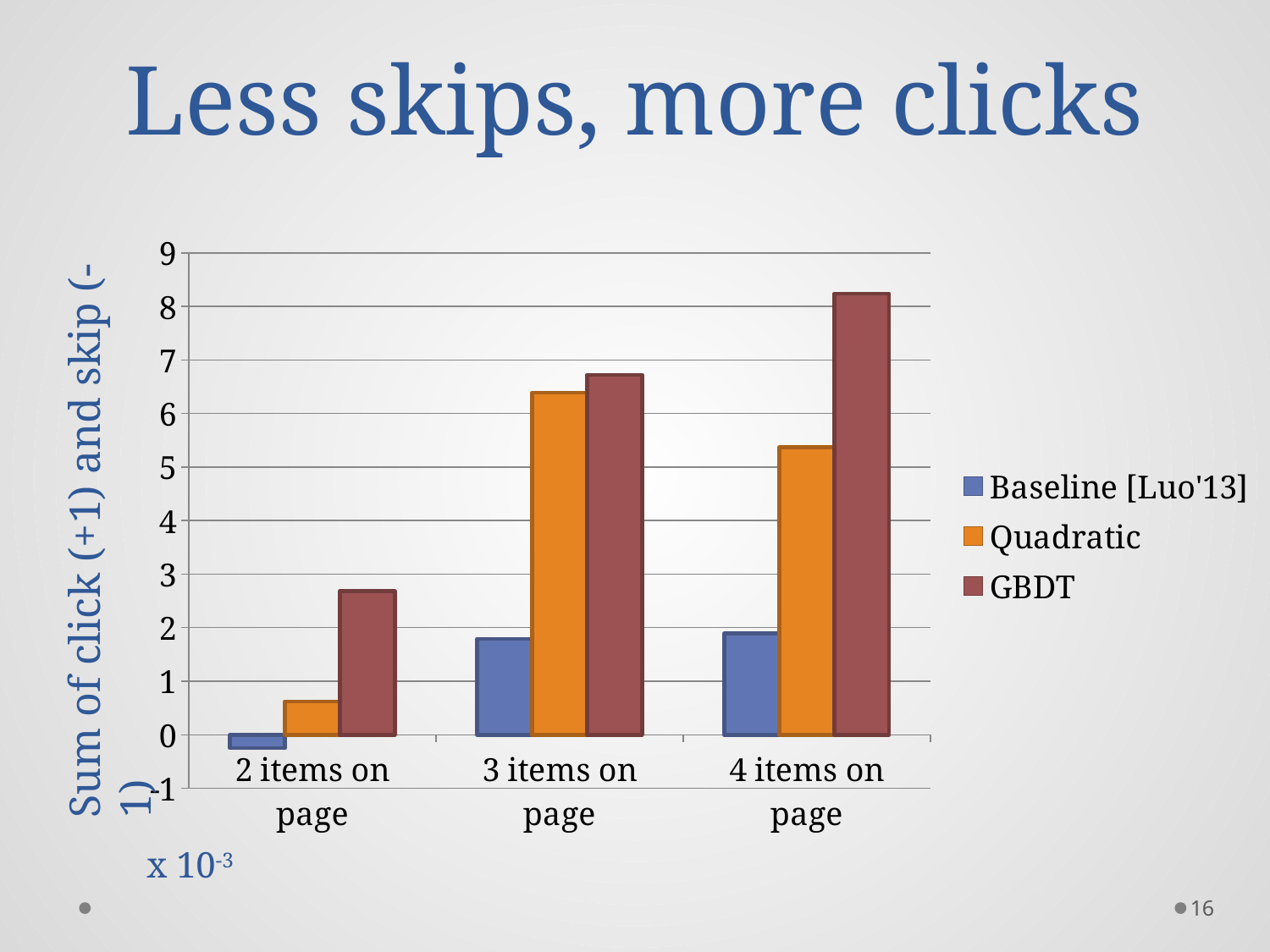
Which is larger: the GBDT value for 2 items on page or the GBDT value for 3 items on page? 3 items on page Which is larger: the Quadratic value for 3 items on page or the Quadratic value for 4 items on page? 3 items on page Is the Quadratic value for 4 items on page greater or less than 6? less What kind of chart is shown on the slide? bar chart How many categories are shown on the x axis? 3 Do the GBDT values rise or fall as the number of items on page increases? rise How many series does the legend list? 3 Is the GBDT value for 4 items on page greater or less than 8? greater Which series has the highest value for 4 items on page? GBDT Which series has the lowest value for 2 items on page? Baseline [Luo'13] Is the Baseline [Luo'13] value for 2 items on page greater or less than 0? less What is the title of the slide containing the chart? Less skips, more clicks